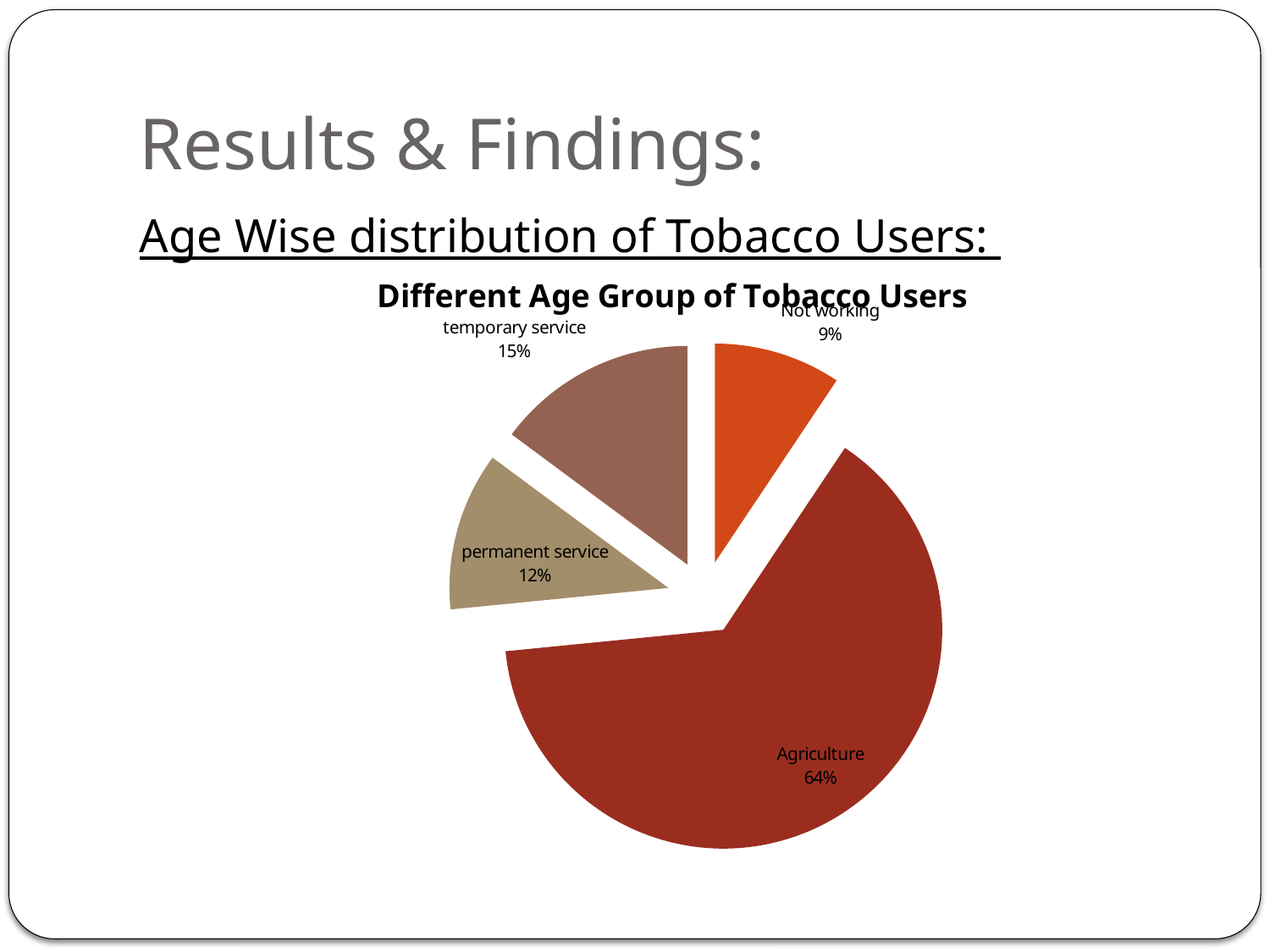
How many slices does the pie chart have? 4 What percentage is shown for permanent service? 12% What is the title of the chart? Different Age Group of Tobacco Users What percentage is shown for Not working? 9% Which category has the largest share of the pie? Agriculture What percentage of the pie does Agriculture represent? 64% Which category has the smallest share of the pie? Not working What is the difference in percentage points between temporary service and permanent service? 3 What type of chart is shown on the slide? Pie chart Which is larger, the share for permanent service or the share for Not working? permanent service What is the difference in percentage points between Agriculture and temporary service? 49 What percentage is shown for temporary service? 15%